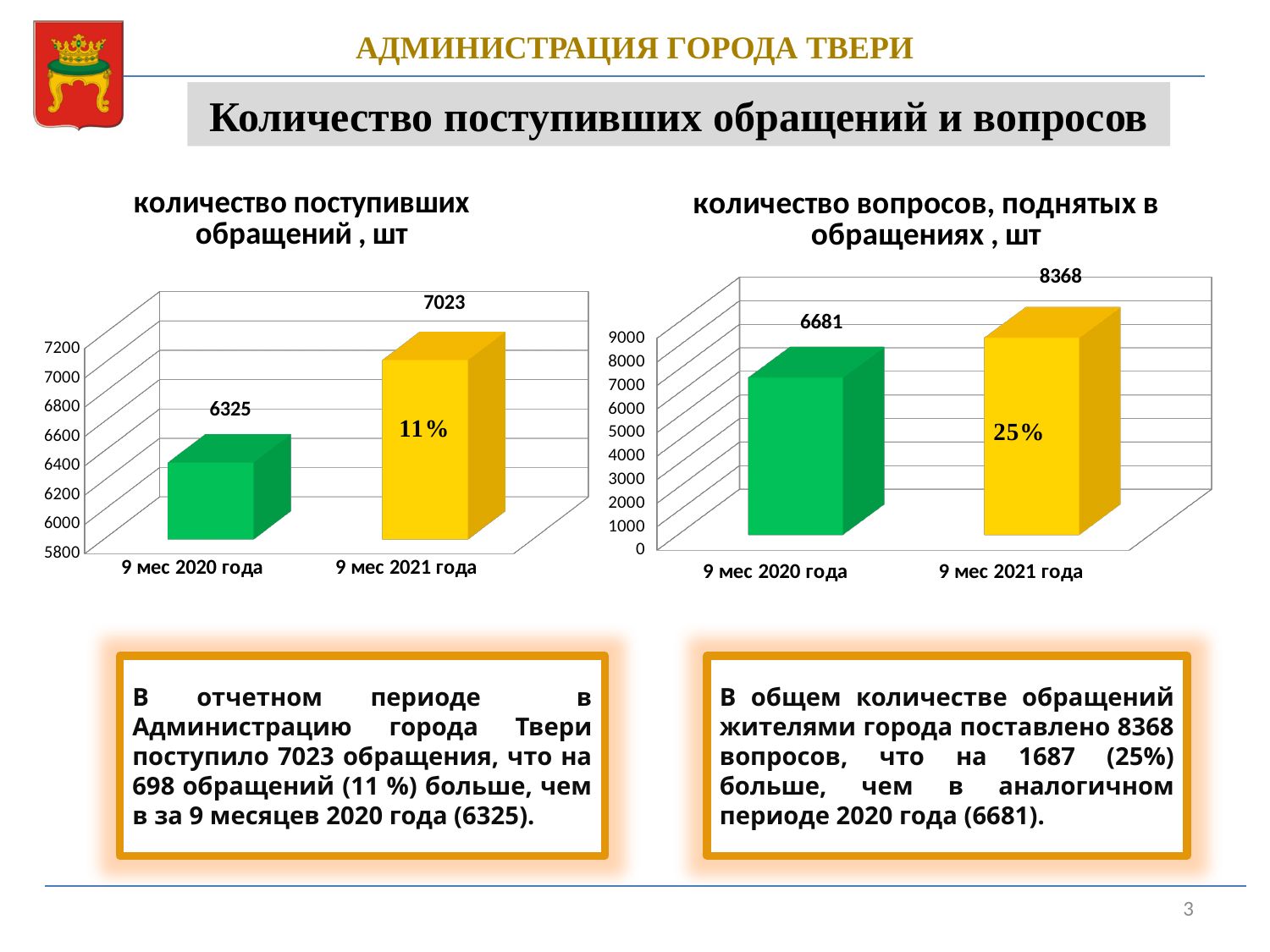
In the left chart (количество поступивших обращений, шт), which category has the highest value? 9 мес 2021 года In the right chart (количество вопросов, поднятых в обращениях, шт), what is the difference between the values for 9 мес 2021 года and 9 мес 2020 года? 1687 In the right chart (количество вопросов, поднятых в обращениях, шт), which is larger: the value for 9 мес 2020 года or 9 мес 2021 года? 9 мес 2021 года In the right chart (количество вопросов, поднятых в обращениях, шт), what is the value for 9 мес 2020 года? 6681 In the right chart (количество вопросов, поднятых в обращениях, шт), which category has the lowest value? 9 мес 2020 года In the left chart (количество поступивших обращений, шт), what is the value for 9 мес 2020 года? 6325 In the left chart (количество поступивших обращений, шт), what is the difference between the values for 9 мес 2021 года and 9 мес 2020 года? 698 How many categories are shown in the left chart (количество поступивших обращений, шт)? 2 What kind of chart is the right chart (количество вопросов, поднятых в обращениях, шт)? bar chart In the left chart (количество поступивших обращений, шт), what is the value for 9 мес 2021 года? 7023 In the right chart (количество вопросов, поднятых в обращениях, шт), what is the value for 9 мес 2021 года? 8368 What percentage label is printed on the 9 мес 2021 года bar in the left chart (количество поступивших обращений, шт)? 11%